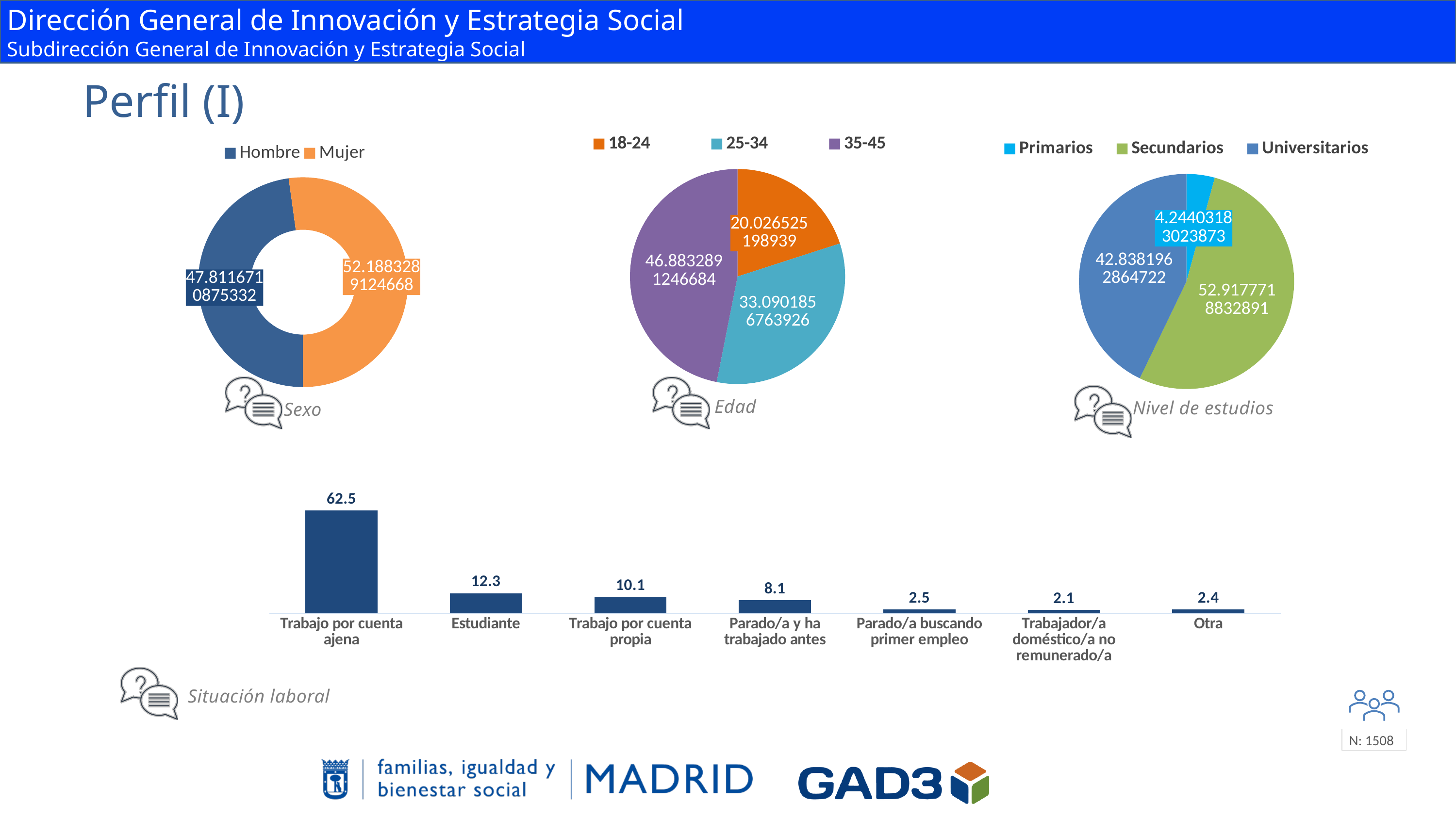
How many entries does the legend of the Nivel de estudios chart list? 3 In the Edad pie chart, which age group has the largest share? 35-45 In the Sexo chart, which is larger: Hombre or Mujer? Mujer In the Situación laboral bar chart, which category has the highest value? Trabajo por cuenta ajena In the Situación laboral bar chart, which is larger: Parado/a y ha trabajado antes or Parado/a buscando primer empleo? Parado/a y ha trabajado antes In the Situación laboral bar chart, what is the difference between Trabajo por cuenta ajena and Estudiante? 50.2 In the Situación laboral bar chart, what is the value for Estudiante? 12.3 In the Nivel de estudios pie chart, which category has the smallest share? Primarios What kind of chart is the Situación laboral chart? Bar chart In the Situación laboral bar chart, what is the value for Trabajo por cuenta propia? 10.1 How many categories does the Situación laboral bar chart show? 7 In the Situación laboral bar chart, which category has the lowest value? Trabajador/a doméstico/a no remunerado/a